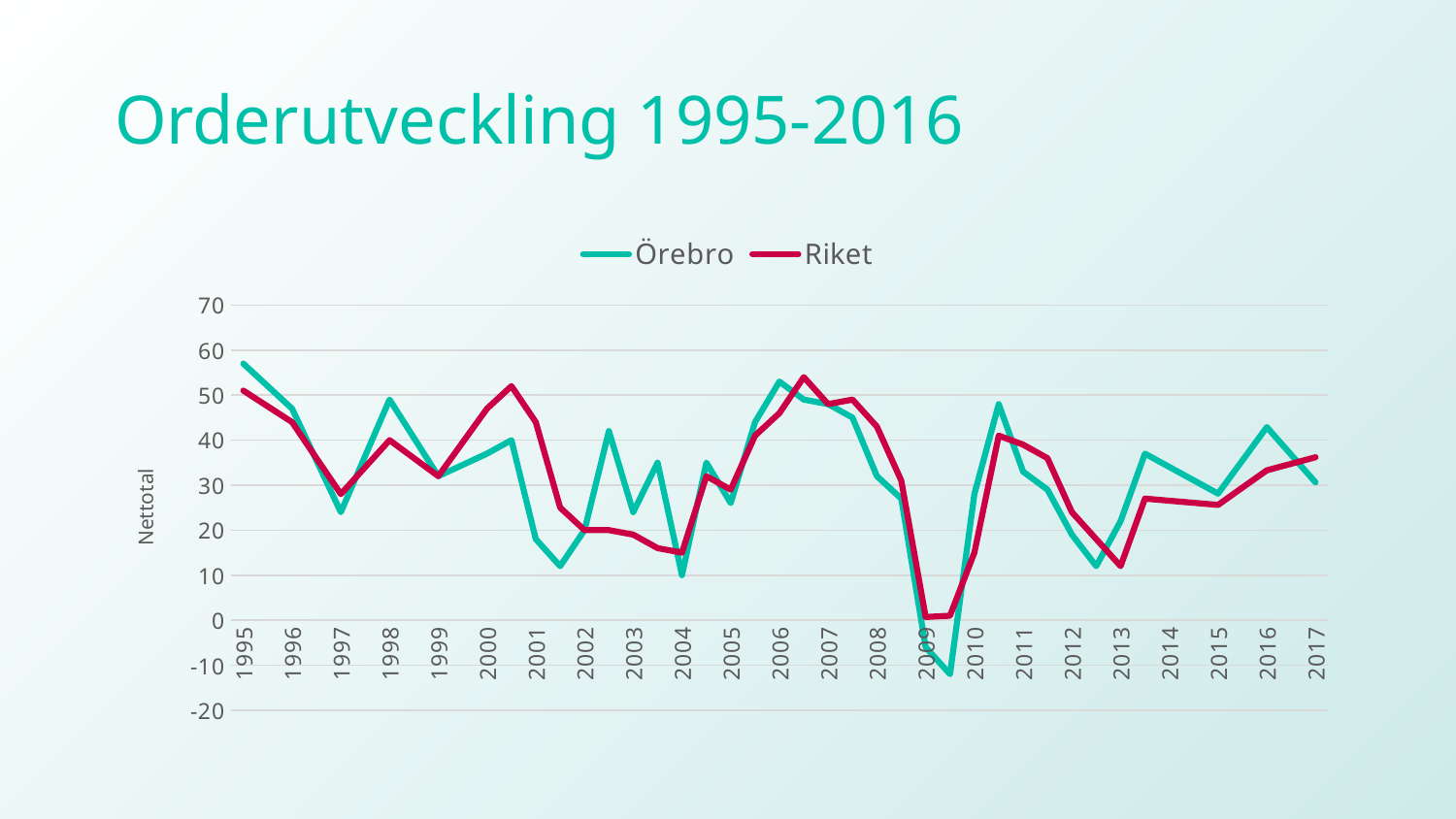
What kind of chart is shown on the slide? line chart Is the value for Riket in 2013 greater or less than 20? less What is the title of the chart? Orderutveckling 1995-2016 What is the label on the vertical axis? Nettotal How many series does the legend list? 2 Is the value for Örebro in 2009 greater or less than 0? less Is the value for Örebro in 2001 greater or less than 20? less In 2009, which series has the higher value, Örebro or Riket? Riket In 2003, which series has the higher value, Örebro or Riket? Örebro How many years are labelled on the x axis? 23 In which year does the Örebro series reach its lowest value? 2009